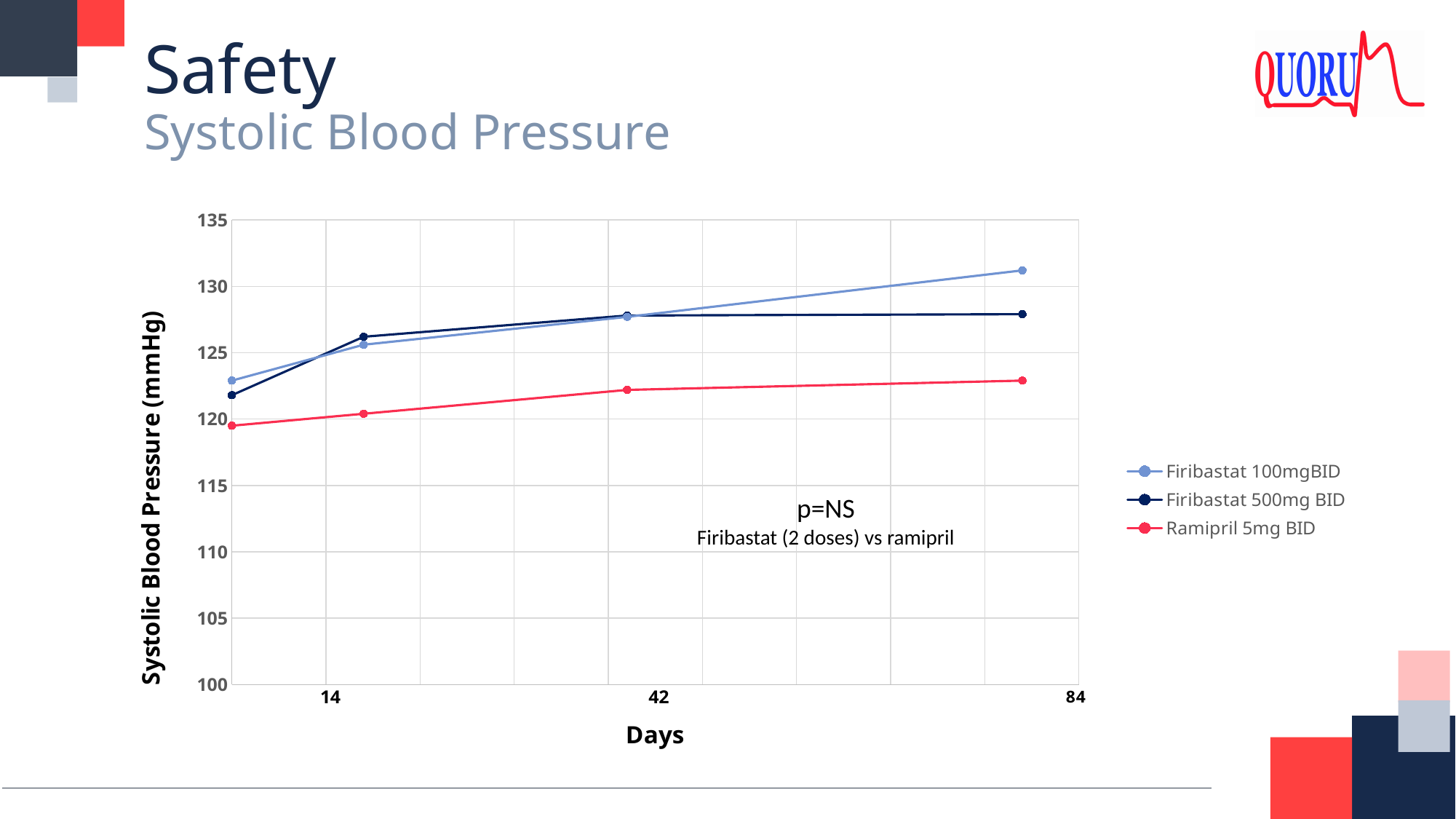
What kind of chart is shown on the slide? Line chart At day 84, which is higher: Firibastat 100mgBID or Ramipril 5mg BID? Firibastat 100mgBID How many data points are plotted for the Ramipril 5mg BID series? 4 Does the Firibastat 100mgBID series rise or fall over the days shown? Rise Is the value for Firibastat 500mg BID at day 84 greater or less than 130? less Which series has the lowest systolic blood pressure across all time points? Ramipril 5mg BID Is the value for Firibastat 100mgBID at day 84 greater or less than 130? greater What is the label of the y axis? Systolic Blood Pressure (mmHg) How many series does the legend list? 3 What p-value annotation is shown on the chart? p=NS Is the value for Ramipril 5mg BID at day 84 greater or less than 120? greater Which series has the highest systolic blood pressure at day 84? Firibastat 100mgBID